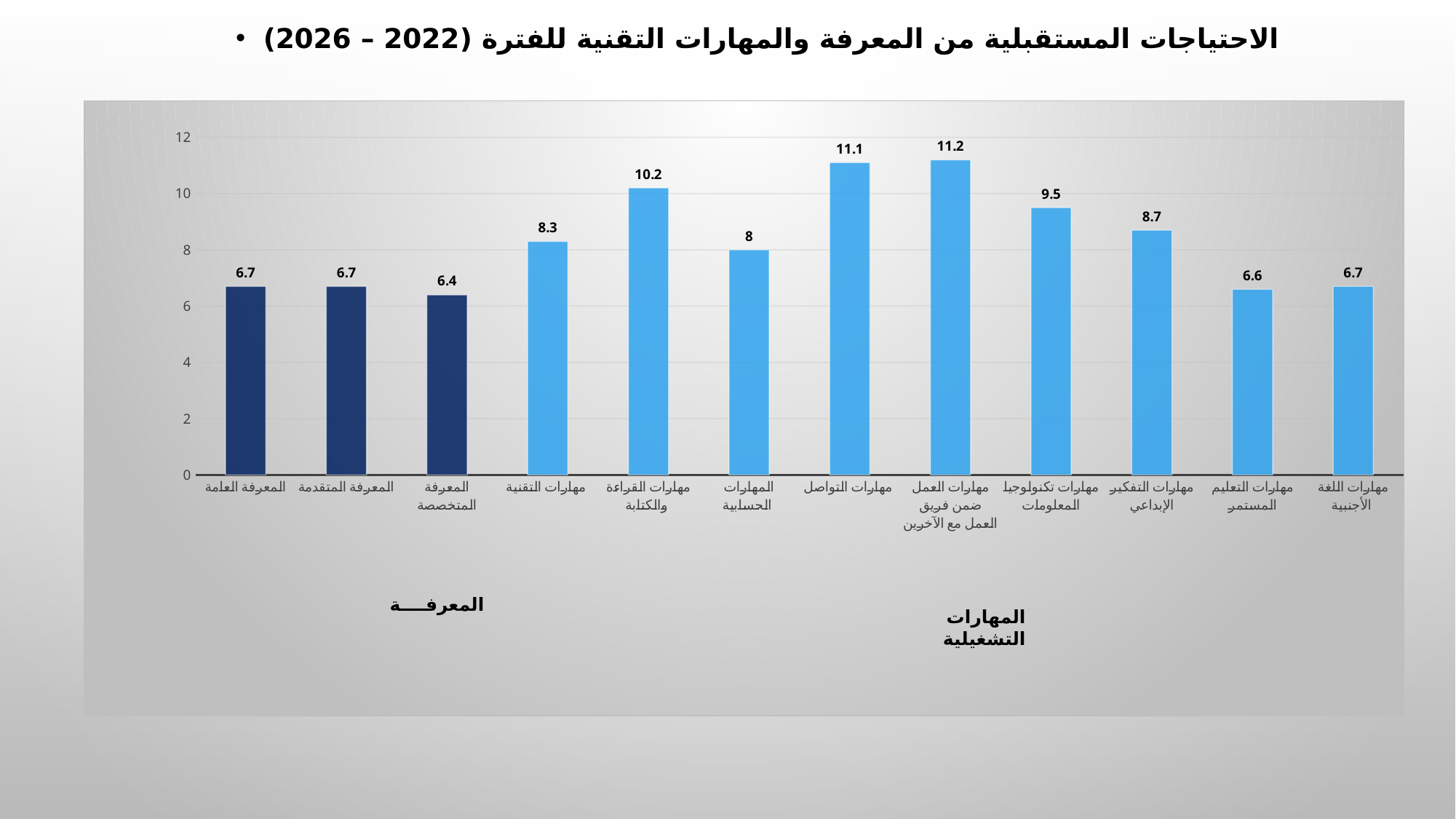
Which group label is shown under the dark blue bars? المعرفة What is the value for مهارات اللغة الأجنبية? 6.7 Is the value for مهارات التعليم المستمر greater or less than 8? less What is the value for مهارات تكنولوجيا المعلومات? 9.5 Which is larger, the value for مهارات التقنية or the value for مهارات التفكير الإبداعي? مهارات التفكير الإبداعي What is the difference between the values for مهارات التواصل and المهارات الحسابية? 3.1 How many categories are shown in the chart? 12 Which category has the lowest value? المعرفة المتخصصة What is the value for مهارات القراءة والكتابة? 10.2 What is the value for المعرفة المتخصصة? 6.4 What kind of chart is shown on the slide? bar chart Which category has the highest value? مهارات العمل ضمن فريق العمل مع الآخرين